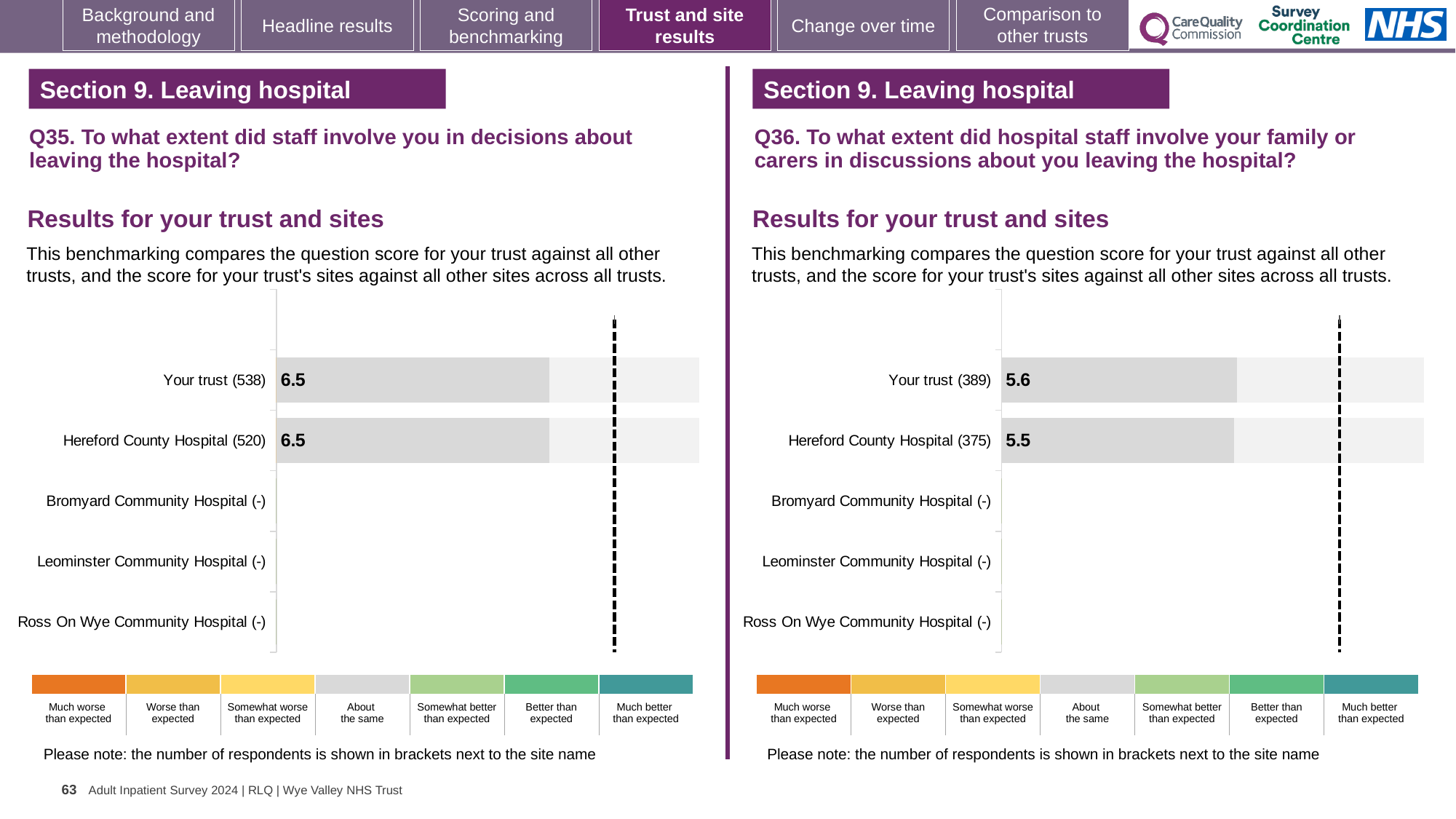
In the Q35 chart on the left, what is the score for Hereford County Hospital? 6.5 In the Q35 chart on the left, what is the score for Your trust? 6.5 What kind of chart is used in the Q35 chart on the left? Bar chart Which category label appears at the bottom of the y axis in the Q35 chart on the left? Ross On Wye Community Hospital (-) In the Q36 chart on the right, what is the score for Your trust? 5.6 How many site or trust categories are listed on the y axis of the Q36 chart on the right? 5 In the Q36 chart on the right, what is the difference between the score for Your trust and the score for Hereford County Hospital? 0.1 In the Q36 chart on the right, what is the score for Hereford County Hospital? 5.5 In the Q35 chart on the left, how many respondents are shown in brackets for Your trust? 538 In the Q36 chart on the right, how many categories have a plotted bar with a score? 2 In the Q35 chart on the left, what is the difference between the score for Your trust and the score for Hereford County Hospital? 0 In the Q36 chart on the right, how many respondents are shown in brackets for Hereford County Hospital? 375